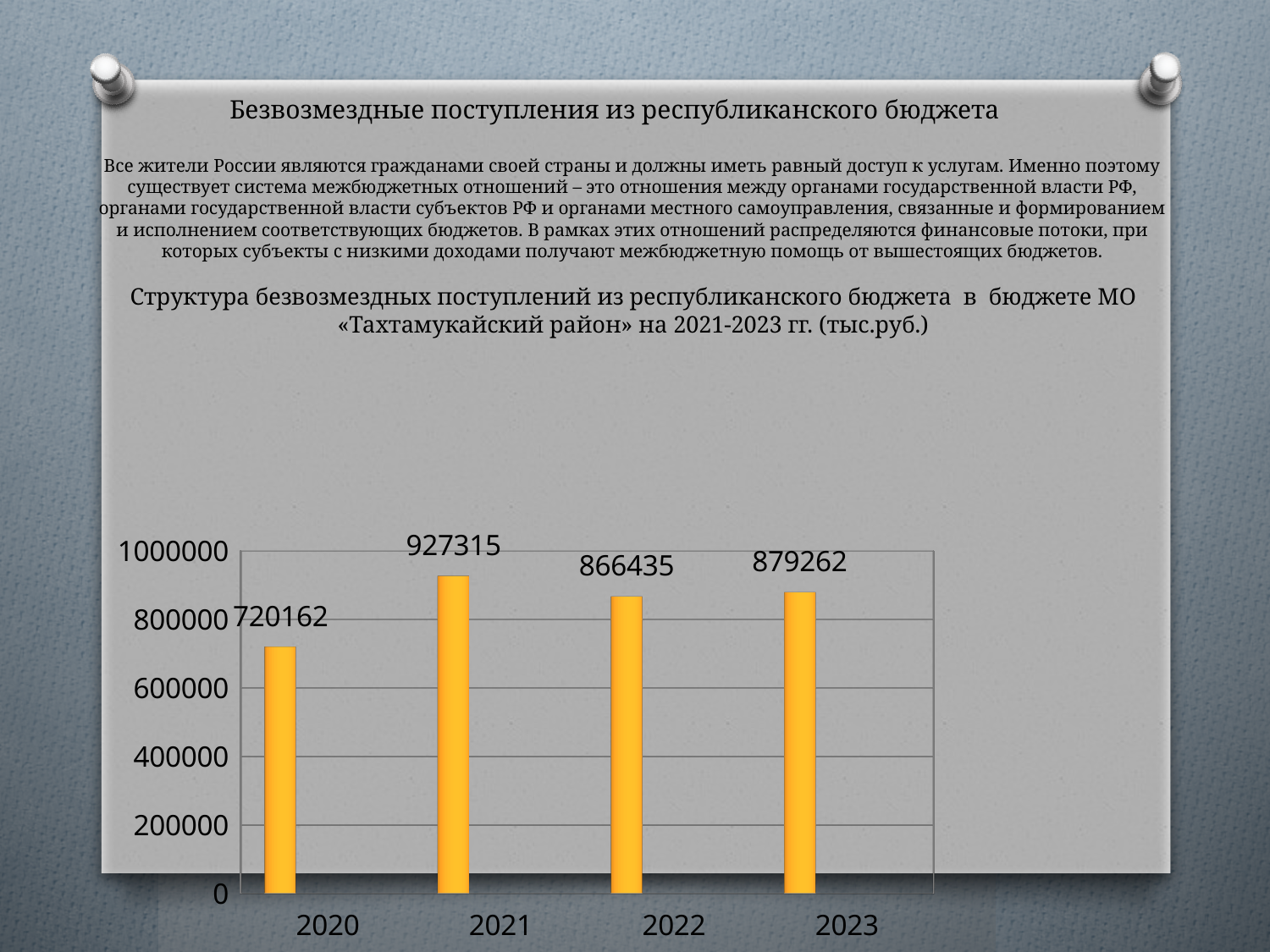
Which year has the lowest value? 2020 What is the value for 2021? 927315 What is the value for 2020? 720162 What is the difference between the values for 2021 and 2020? 207153 Which year has the highest value? 2021 Which is larger, the value for 2022 or the value for 2020? 2022 Is the value for 2020 greater or less than 800000? less What kind of chart is shown on the slide? bar chart What is the difference between the values for 2023 and 2022? 12827 What is the value for 2022? 866435 How many years are shown on the x axis? 4 What is the value for 2023? 879262